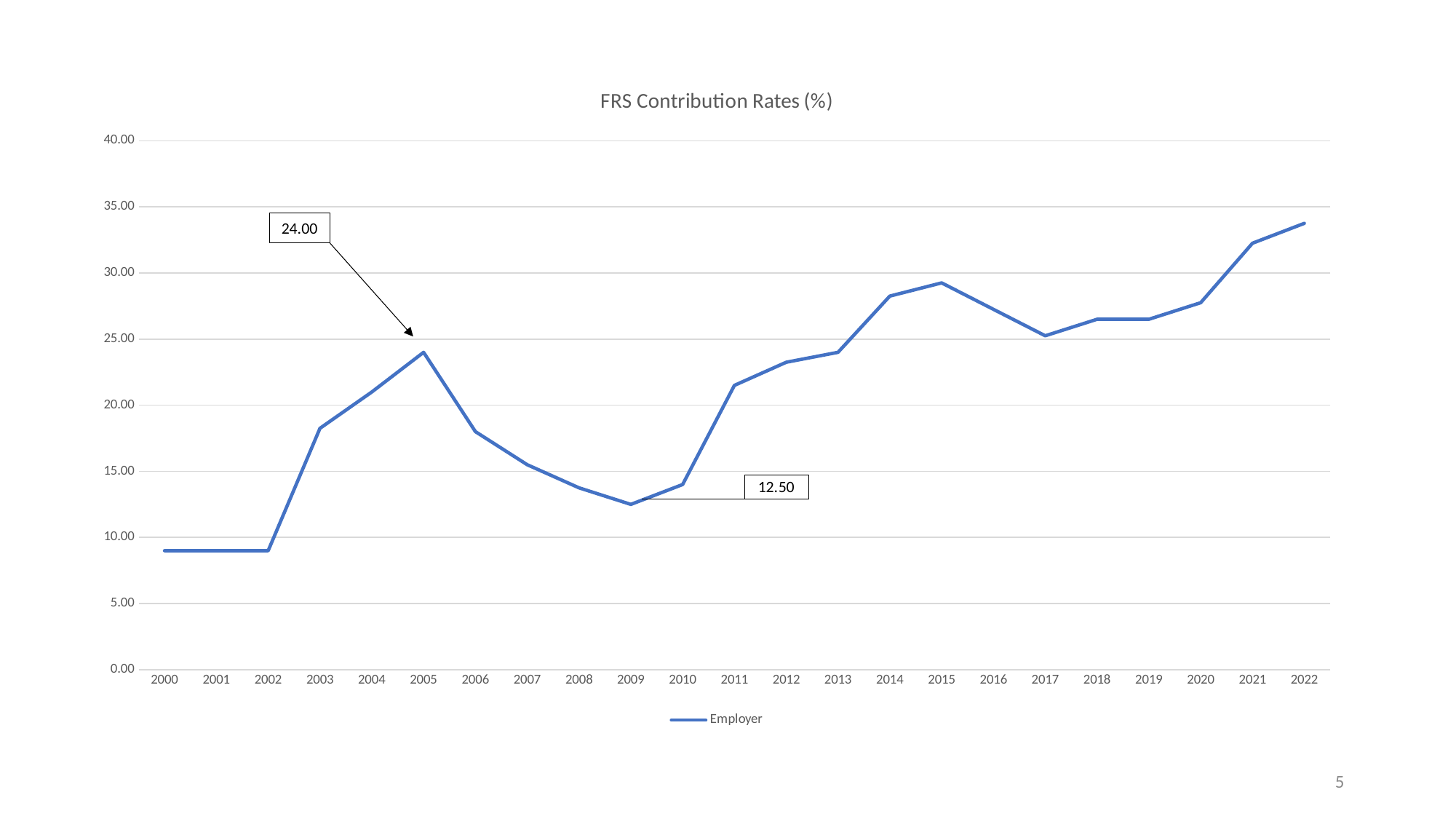
How many series does the legend list? 1 How many years are plotted along the x axis? 23 Do the values rise or fall from 2005 to 2009? fall Which year has the highest Employer contribution rate? 2022 Is the value for 2000 greater or less than 10.00? less What kind of chart is shown on the slide? line chart What is the title of the chart? FRS Contribution Rates (%) What is the Employer contribution rate labelled for 2009? 12.50 What is the difference between the labelled values for 2005 and 2009? 11.50 What is the name of the series shown in the legend? Employer Is the value for 2021 greater or less than 30.00? greater What is the Employer contribution rate labelled for 2005? 24.00